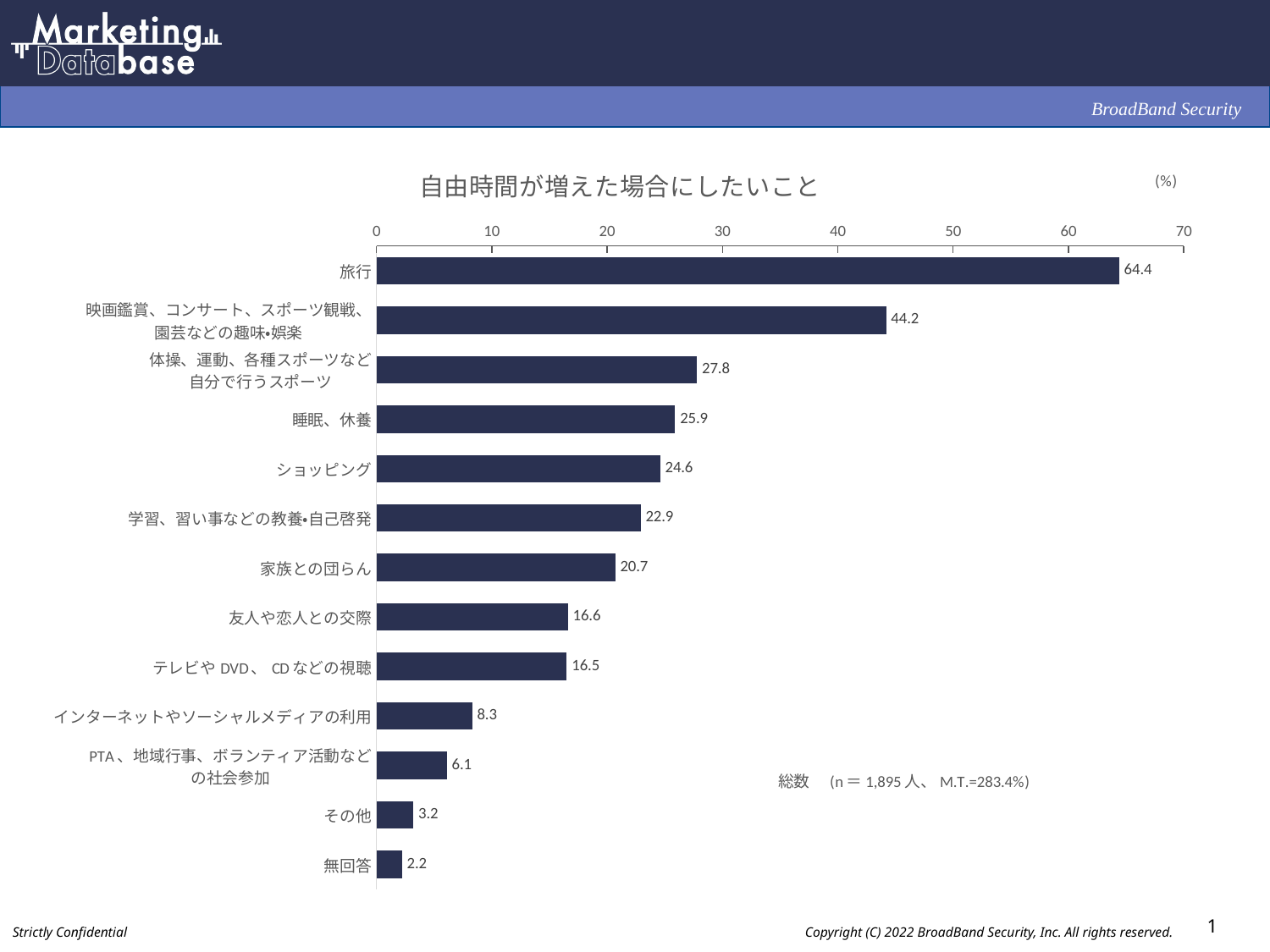
What kind of chart is shown on the slide? bar chart What is the value for 家族との団らん? 20.7 What is the title of the chart? 自由時間が増えた場合にしたいこと Which category has the highest value? 旅行 How many categories are shown in the chart? 13 What is the difference between the values for 旅行 and 映画鑑賞、コンサート、スポーツ観戦、園芸などの趣味•娯楽? 20.2 What is the value for 旅行? 64.4 Which category has the lowest value? 無回答 Is the value for 旅行 greater or less than 60? greater What is the value for インターネットやソーシャルメディアの利用? 8.3 Which is larger, the value for 睡眠、休養 or the value for 学習、習い事などの教養•自己啓発? 睡眠、休養 What is the value for ショッピング? 24.6